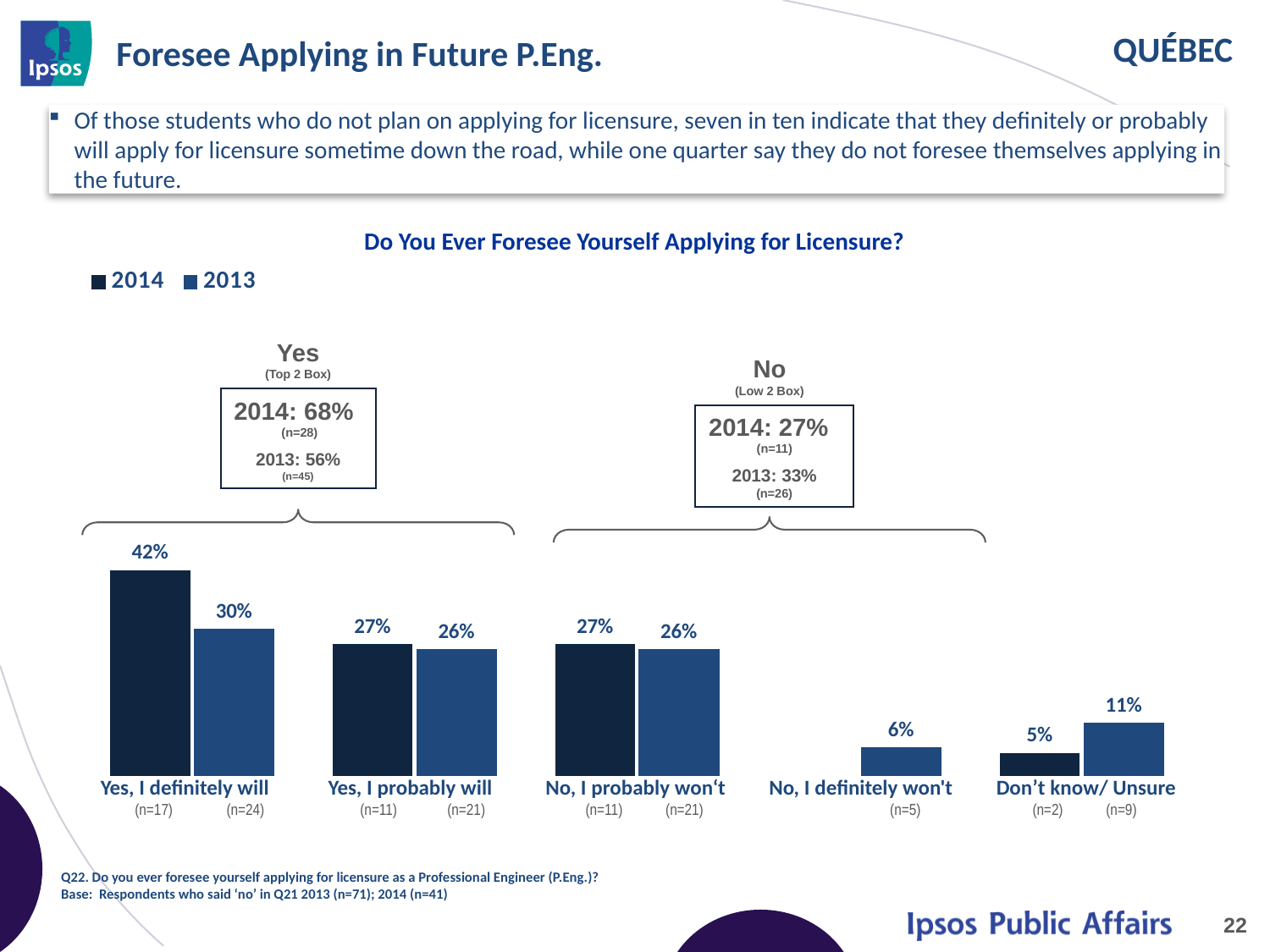
Which category has the highest 2014 value? Yes, I definitely will What kind of chart is shown on the slide? Bar chart Which category has the lowest 2013 value? No, I definitely won't What is the 2013 value for "Yes, I definitely will"? 30% How many categories are shown on the x axis? 5 What is the 2014 value for "Yes, I definitely will"? 42% How many series does the legend list? 2 What is the 2013 value for "Don't know/ Unsure"? 11% For "Don't know/ Unsure", which year has the larger value, 2014 or 2013? 2013 What is the 2014 value for "Yes, I probably will"? 27% What is the title of the chart? Do You Ever Foresee Yourself Applying for Licensure? What is the difference between the 2014 and 2013 values for "Yes, I definitely will"? 12%